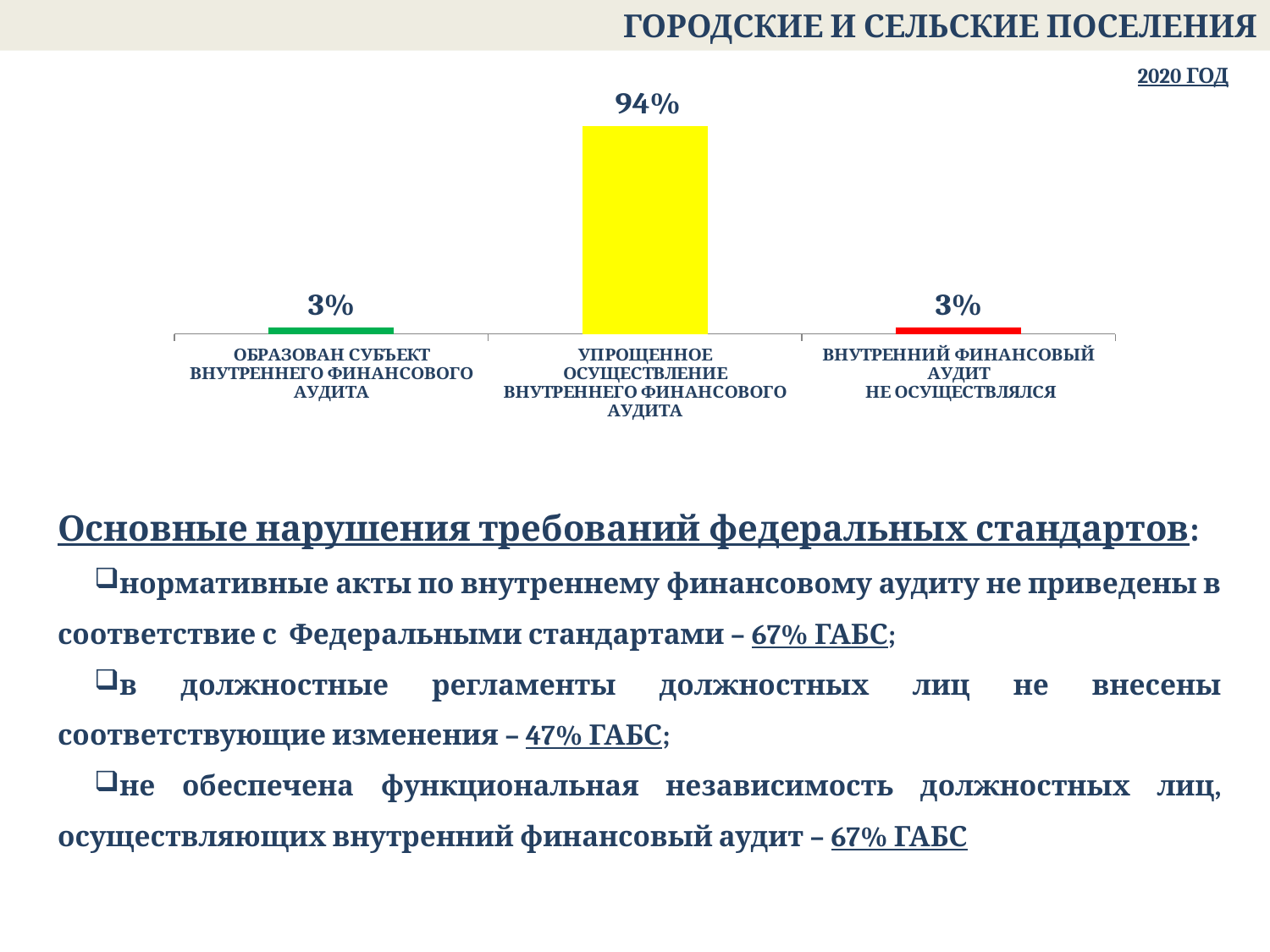
What is the value for «Образован субъект внутреннего финансового аудита»? 3% What is the difference between the value for «Упрощенное осуществление внутреннего финансового аудита» and the value for «Образован субъект внутреннего финансового аудита»? 91% How many categories are shown in the chart? 3 What is the value for «Внутренний финансовый аудит не осуществлялся»? 3% What is the total of the three values shown in the chart? 100% What kind of chart is shown on the slide? Bar chart Which is larger: the value for «Упрощенное осуществление внутреннего финансового аудита» or the value for «Внутренний финансовый аудит не осуществлялся»? Упрощенное осуществление внутреннего финансового аудита Which category has the highest value? Упрощенное осуществление внутреннего финансового аудита What colour is the bar for «Упрощенное осуществление внутреннего финансового аудита»? Yellow What is the value for «Упрощенное осуществление внутреннего финансового аудита»? 94% What year is indicated above the chart? 2020 год